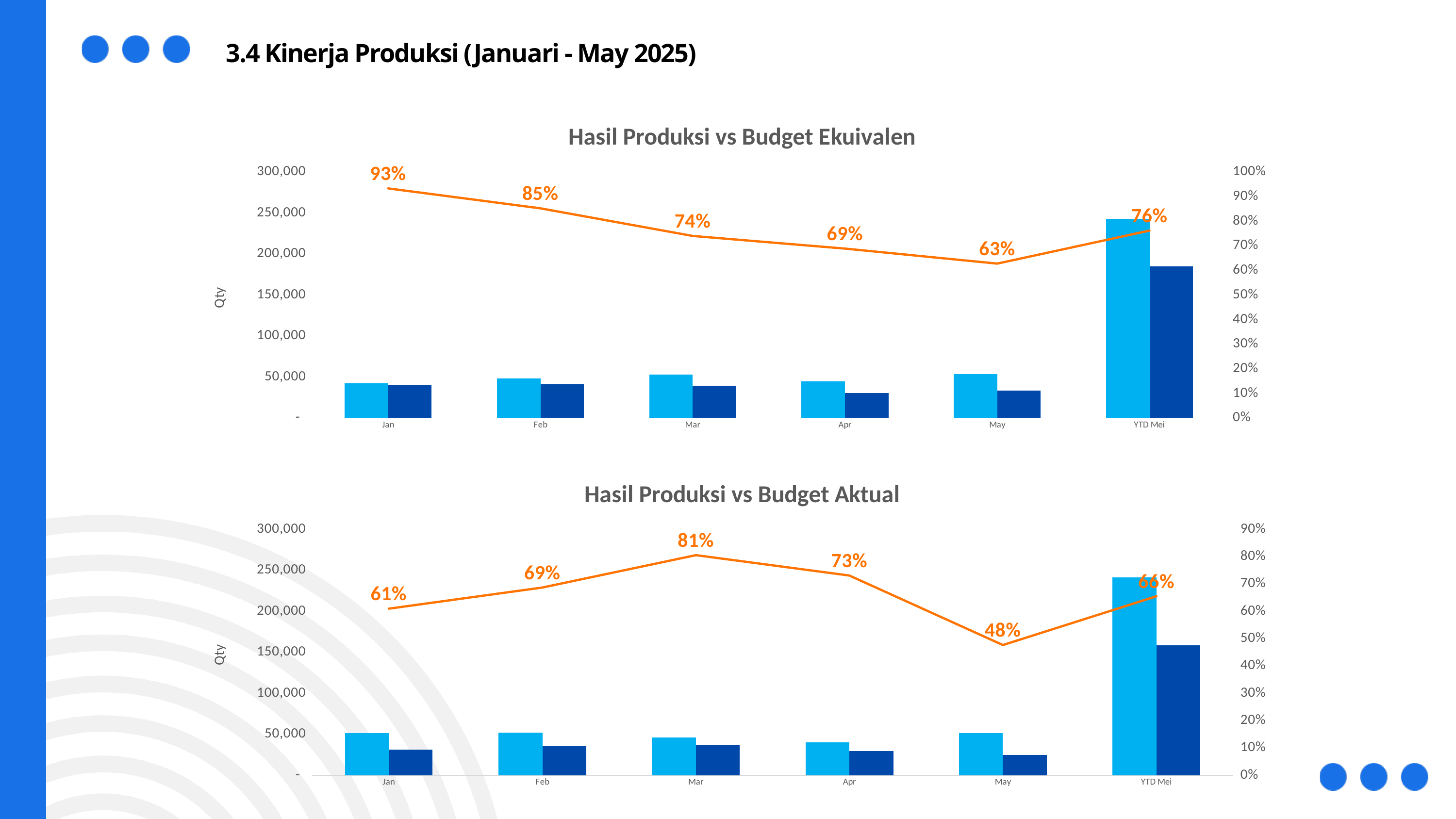
In the 'Hasil Produksi vs Budget Ekuivalen' chart, is the light blue bar for YTD Mei greater or less than 200,000? greater In the 'Hasil Produksi vs Budget Aktual' chart, which is larger, the percentage for Feb or the percentage for Apr? Apr In the 'Hasil Produksi vs Budget Ekuivalen' chart, what percentage is shown for YTD Mei? 76% In the 'Hasil Produksi vs Budget Aktual' chart, what percentage is shown for Mar? 81% In the 'Hasil Produksi vs Budget Ekuivalen' chart, what is the difference between the Jan percentage and the May percentage? 30% In the 'Hasil Produksi vs Budget Aktual' chart, is the dark blue bar for YTD Mei greater or less than 200,000? less In the 'Hasil Produksi vs Budget Ekuivalen' chart, does the percentage line rise or fall from Jan to May? fall In the 'Hasil Produksi vs Budget Ekuivalen' chart, which month has the lowest percentage on the line? May In the 'Hasil Produksi vs Budget Ekuivalen' chart, what percentage is shown for Jan? 93% In the 'Hasil Produksi vs Budget Aktual' chart, which category has the highest percentage on the line? Mar How many categories are shown on the x axis of the 'Hasil Produksi vs Budget Ekuivalen' chart? 6 In the 'Hasil Produksi vs Budget Aktual' chart, what percentage is shown for May? 48%